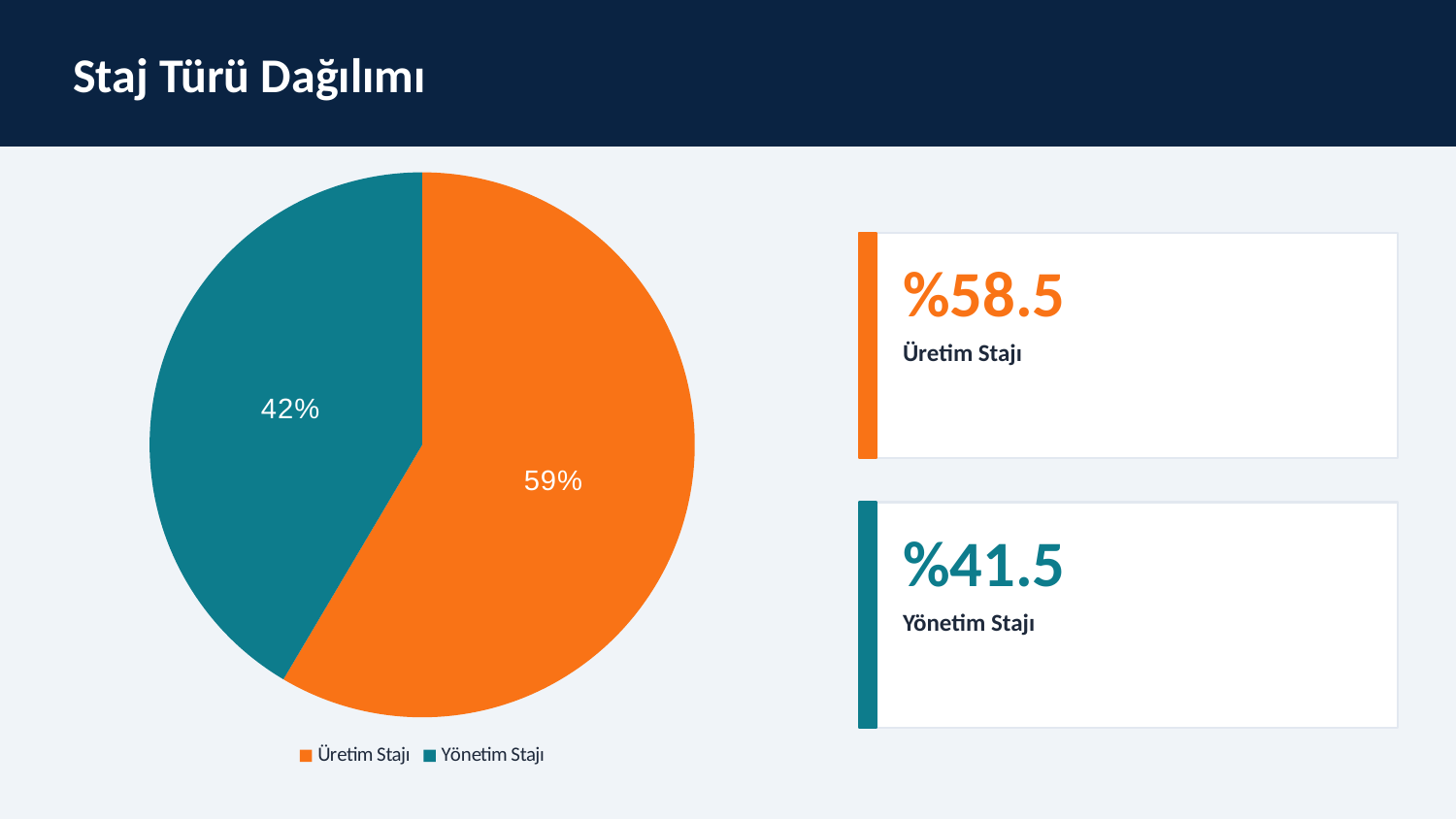
What colour is the Yönetim Stajı slice in the pie chart? Teal How many slices does the pie chart have? 2 What share of the pie does the Yönetim Stajı slice represent, according to its label? 42% What percentage does the pie chart show for Üretim Stajı? 59% What percentage does the pie chart show for Yönetim Stajı? 42% What kind of chart is shown on the slide? Pie chart How many entries does the legend of the pie chart list? 2 Which category has the largest slice in the pie chart? Üretim Stajı Which category has the smallest slice in the pie chart? Yönetim Stajı Which slice is larger in the pie chart, Üretim Stajı or Yönetim Stajı? Üretim Stajı What is the title of the slide containing the pie chart? Staj Türü Dağılımı By how many percentage points does the Üretim Stajı slice exceed the Yönetim Stajı slice, according to the labels on the pie chart? 17 percentage points